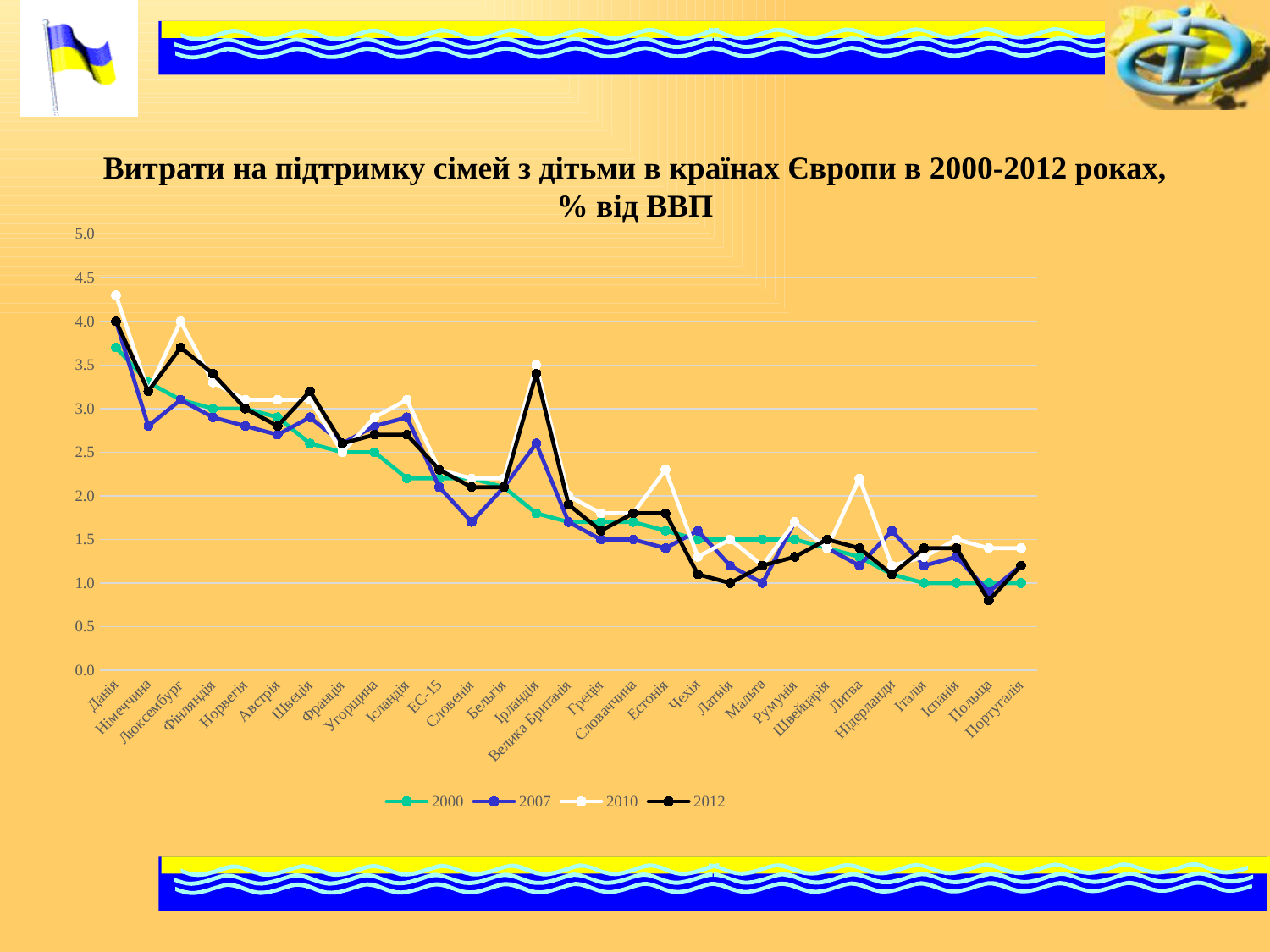
Is the 2012 value for Ірландія greater or less than 3.0? greater Is the 2000 value for Португалія greater or less than 1.5? less Is the 2007 value for Польща greater or less than 1.5? less What kind of chart is shown on the slide? line chart Which is larger: the 2012 value for Данія or the 2012 value for Португалія? Данія Which years are listed in the legend? 2000, 2007, 2010, 2012 How many series does the legend list? 4 Do the values generally rise or fall moving from left to right along the x axis? fall What is the title of the chart? Витрати на підтримку сімей з дітьми в країнах Європи в 2000-2012 роках, % від ВВП Which country has the highest value in the 2010 series? Данія How many countries/categories are plotted along the x axis? 29